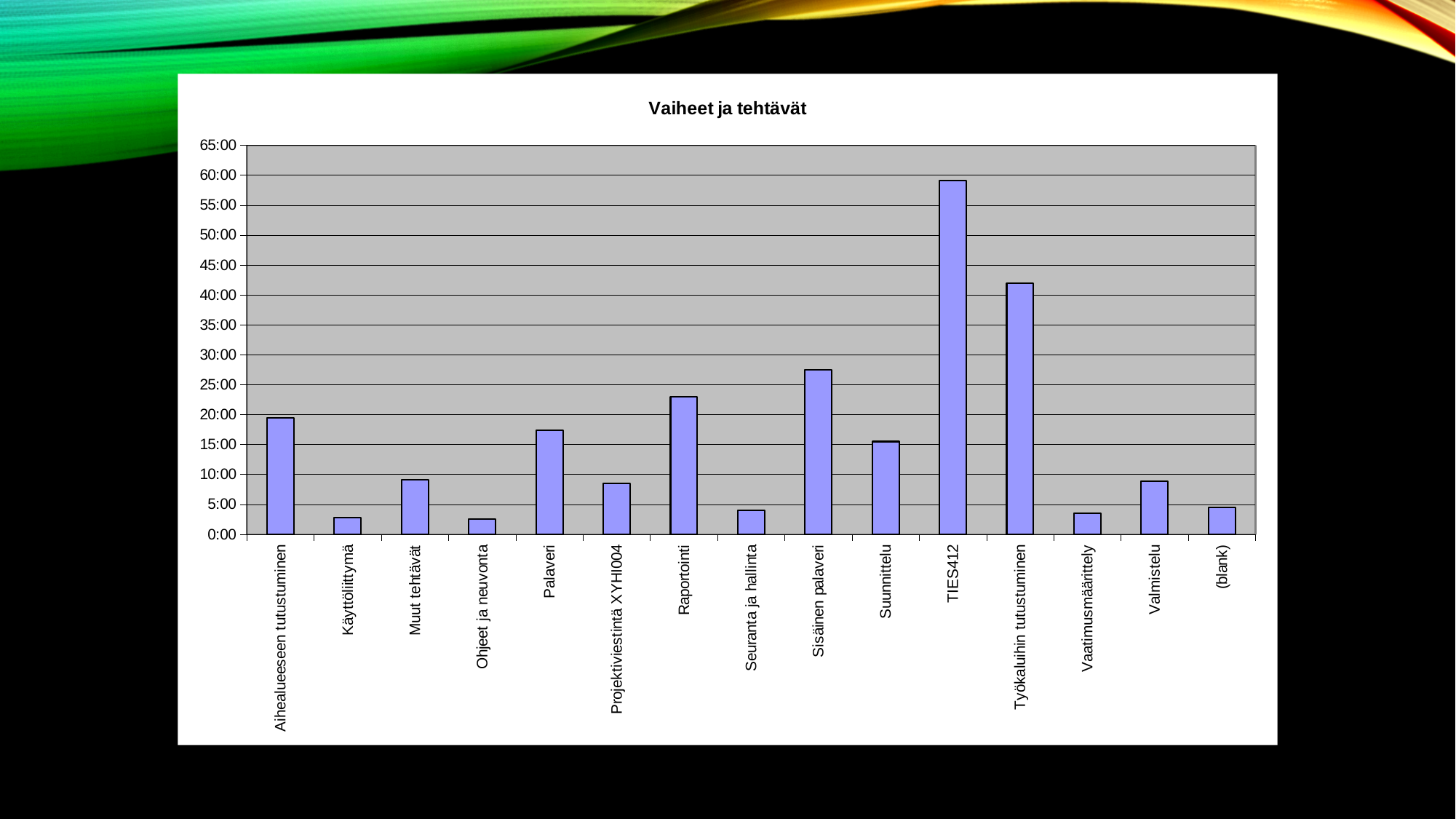
What kind of chart is shown on the slide? bar chart Which is larger, the value for Raportointi or the value for Palaveri? Raportointi Is the value for Raportointi greater or less than 20:00? greater Which category has the highest value in the chart? TIES412 Is the value for Seuranta ja hallinta greater or less than 5:00? less Is the value for Työkaluihin tutustuminen greater or less than 40:00? greater Which is larger, the value for Sisäinen palaveri or the value for Suunnittelu? Sisäinen palaveri What is the title of the chart? Vaiheet ja tehtävät Which is larger, the value for TIES412 or the value for Työkaluihin tutustuminen? TIES412 How many categories are plotted on the x axis of the chart? 15